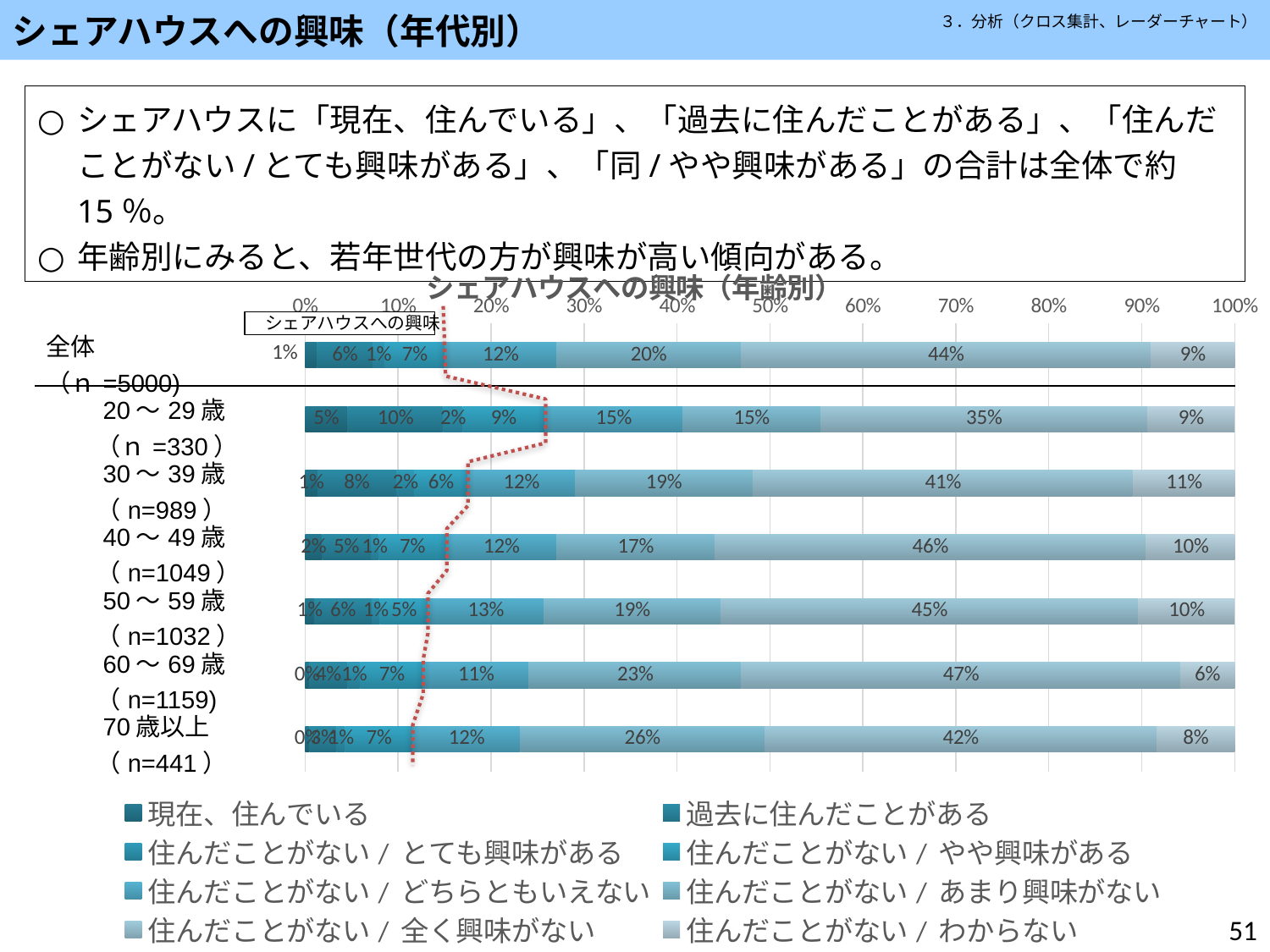
What is the value for 「過去に住んだことがある」 in the 20～29歳 bar? 10% What is the difference between the 「住んだことがない／全く興味がない」 values for 60～69歳 and 20～29歳? 12% Which age group has the lowest value for 「住んだことがない／全く興味がない」? 20～29歳 Which age group has the highest value for 「住んだことがない／全く興味がない」? 60～69歳 What kind of chart is shown on the slide? Stacked bar chart What is the title of the chart? シェアハウスへの興味（年齢別） How many series does the legend list? 8 What is the value for 「住んだことがない／あまり興味がない」 in the 70歳以上 bar? 26% How many age categories (including 全体) are plotted on the chart? 7 What is the value for 「住んだことがない／全く興味がない」 in the 全体 (n=5000) bar? 44% What is the value for 「住んだことがない／全く興味がない」 in the 20～29歳 bar? 35% Which is larger: the 「住んだことがない／わからない」 value for 30～39歳 or for 60～69歳? 30～39歳